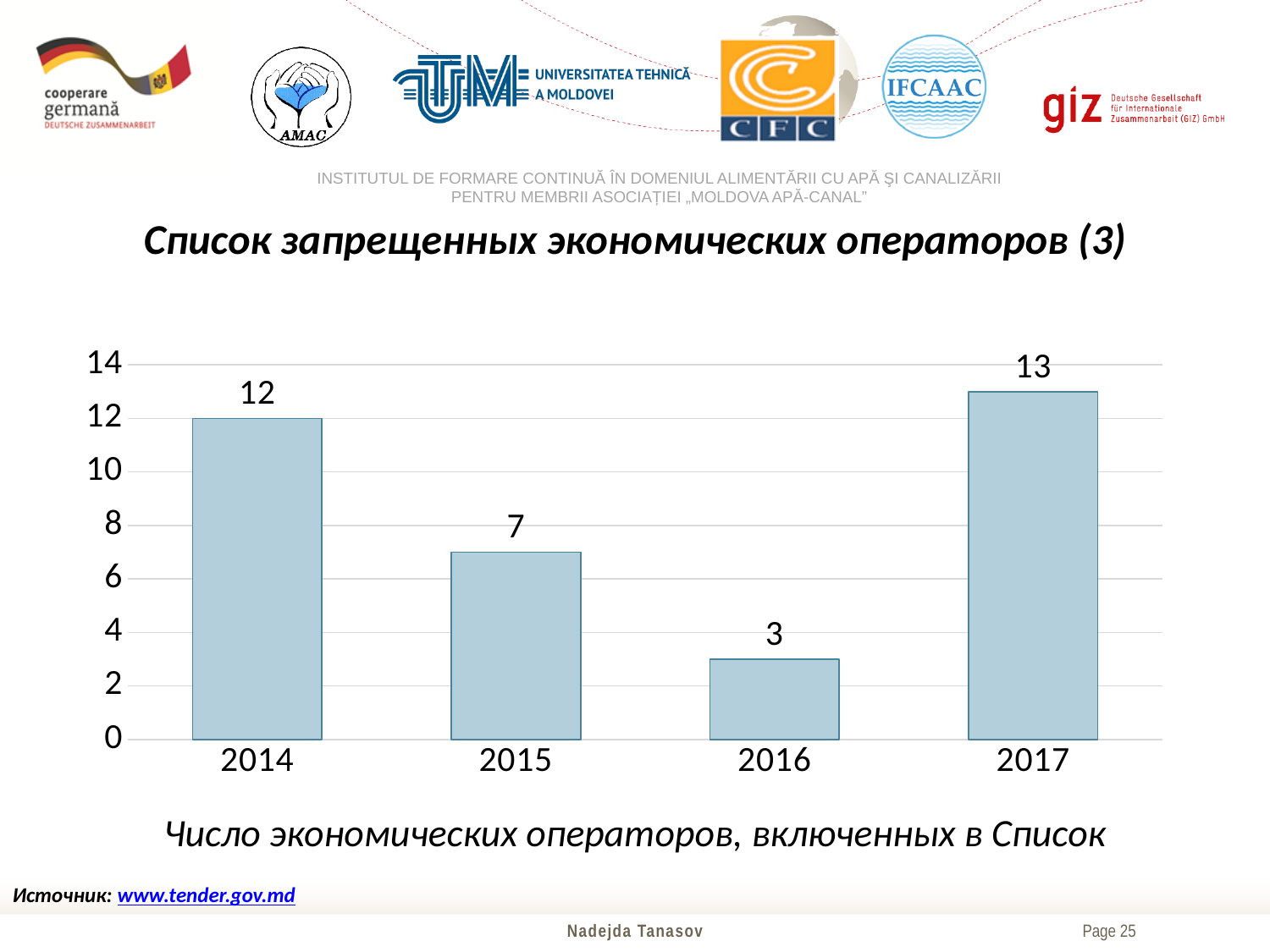
What is the value for 2014? 12 What is the difference between the values for 2014 and 2015? 5 What is the difference between the values for 2017 and 2016? 10 What is the value for 2015? 7 Which year has the highest value? 2017 Is the value for 2015 greater or less than 8? less What is the value for 2016? 3 How many years are shown on the x axis? 4 Which year has the lowest value? 2016 Which is larger, the value for 2014 or the value for 2017? 2017 What is the caption below the chart? Число экономических операторов, включенных в Список What kind of chart is shown on the slide? bar chart